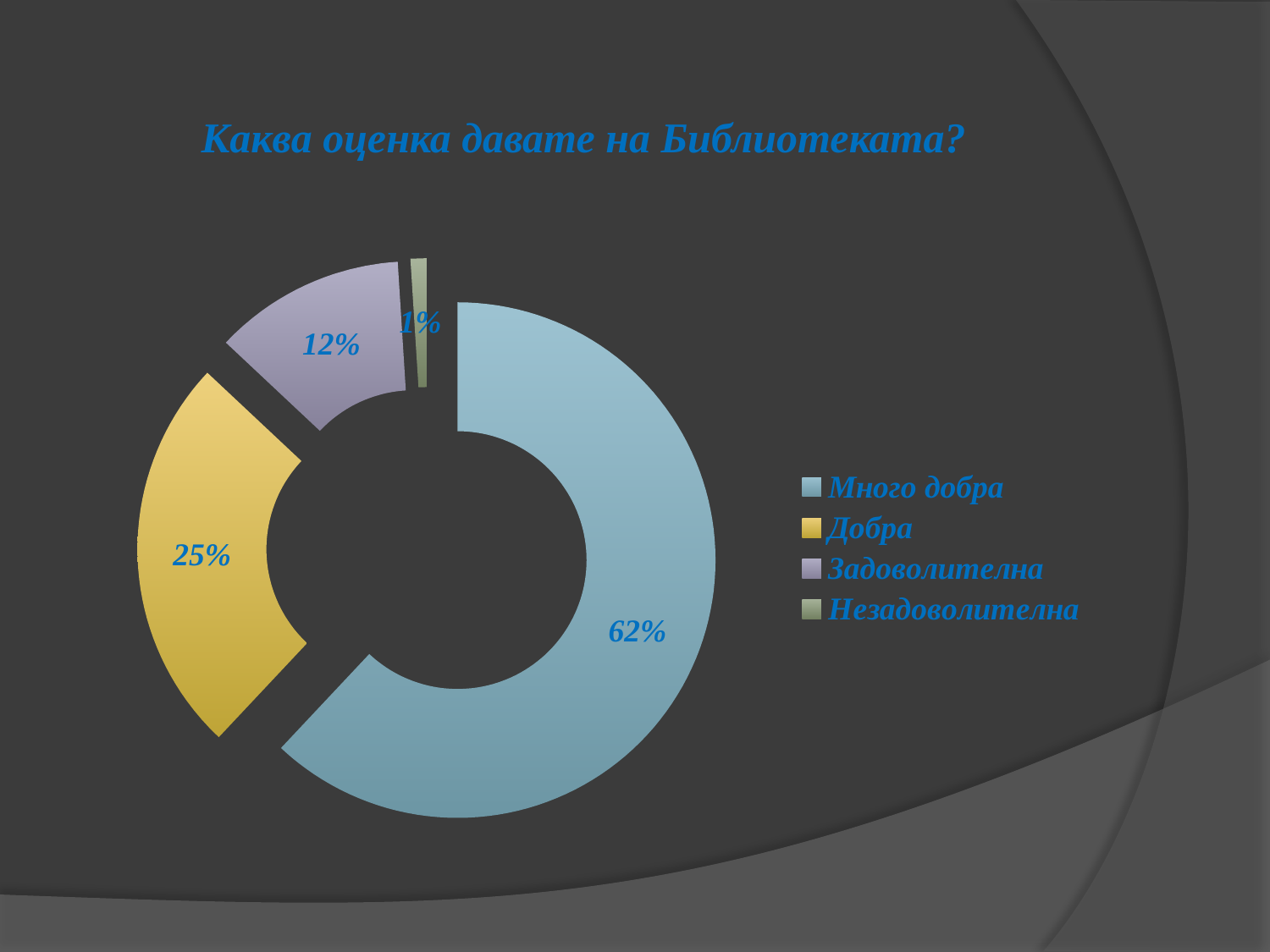
How many categories does the chart show? 4 Which is larger, the share for 'Задоволителна' or for 'Незадоволителна'? Задоволителна What is the value shown for 'Задоволителна'? 12% What is the difference between the shares for 'Много добра' and 'Добра'? 37% Which category has the largest share? Много добра What is the title of the chart? Каква оценка давате на Библиотеката? Which category has the smallest share? Незадоволителна What kind of chart is shown on the slide? Doughnut (pie) chart What is the difference between the shares for 'Добра' and 'Задоволителна'? 13% What is the value shown for 'Добра'? 25% What share of the chart does the 'Много добра' slice represent? 62% What is the value shown for 'Незадоволителна'? 1%